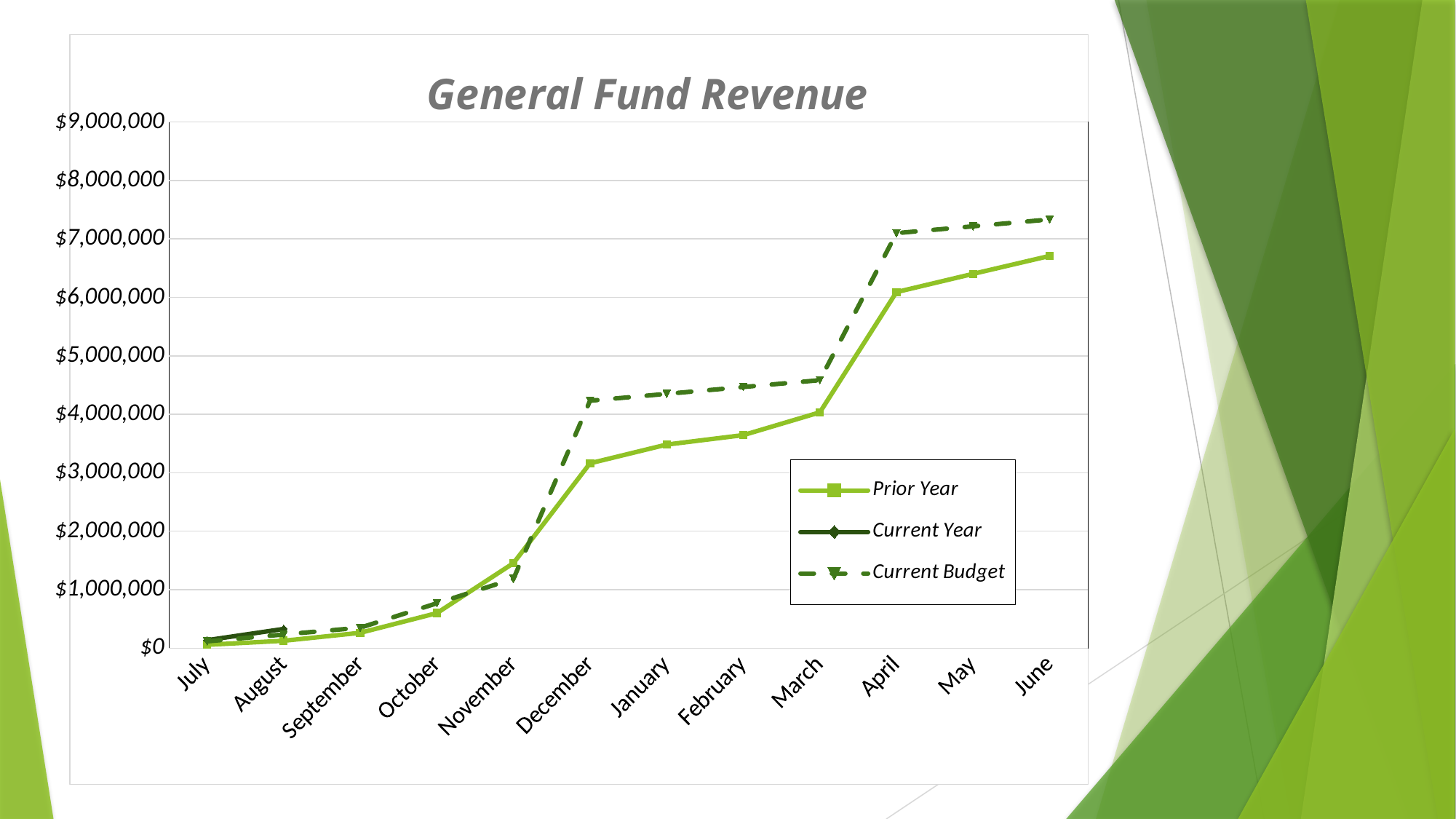
Is the Prior Year value for December greater or less than $4,000,000? less What is the title of the chart? General Fund Revenue In which month is the Prior Year value highest? June What kind of chart is shown on the slide? line chart In which month is the Prior Year value lowest? July Is the Current Budget value for June greater or less than $7,000,000? greater In December, which is larger: the Current Budget value or the Prior Year value? Current Budget How many months are shown along the x axis? 12 Does the Prior Year series rise or fall from July to June? rise Which series is drawn with a dashed line? Current Budget How many series does the legend list? 3 Is the Prior Year value for June greater or less than $6,000,000? greater